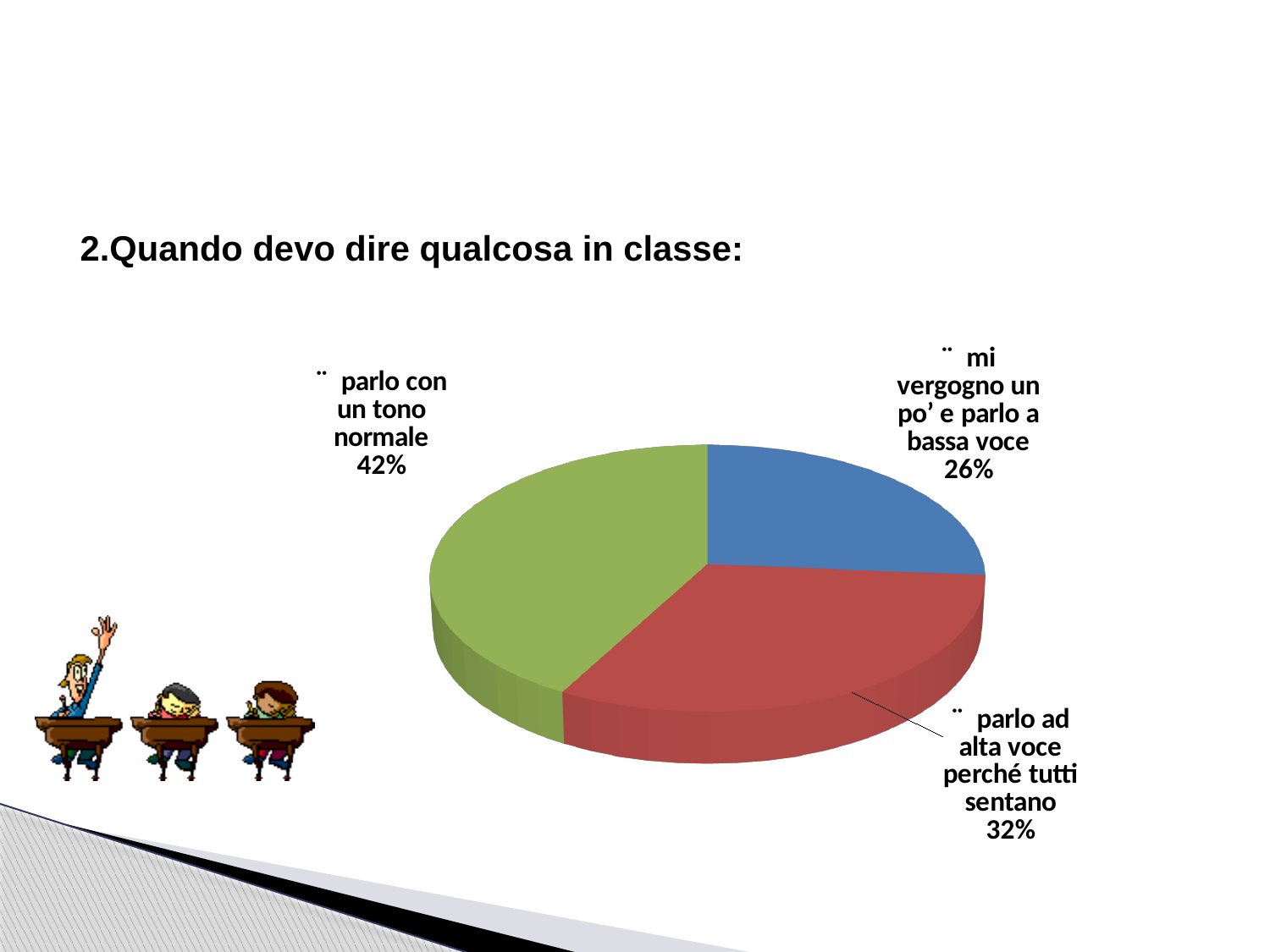
What is the title text above the chart? 2.Quando devo dire qualcosa in classe: What is the difference in percentage points between "parlo con un tono normale" and "parlo ad alta voce perché tutti sentano"? 10 What percentage of the pie is labelled "parlo ad alta voce perché tutti sentano"? 32% How many slices does the pie chart have? 3 What percentage of the pie is labelled "mi vergogno un po' e parlo a bassa voce"? 26% Which slice of the pie is the smallest? mi vergogno un po' e parlo a bassa voce What is the difference in percentage points between "parlo ad alta voce perché tutti sentano" and "mi vergogno un po' e parlo a bassa voce"? 6 Which slice of the pie is the largest? parlo con un tono normale What colour is the slice for "parlo con un tono normale"? green What kind of chart is shown on the slide? pie chart Which is larger: the slice for "parlo ad alta voce perché tutti sentano" or the slice for "mi vergogno un po' e parlo a bassa voce"? parlo ad alta voce perché tutti sentano What percentage of the pie is labelled "parlo con un tono normale"? 42%